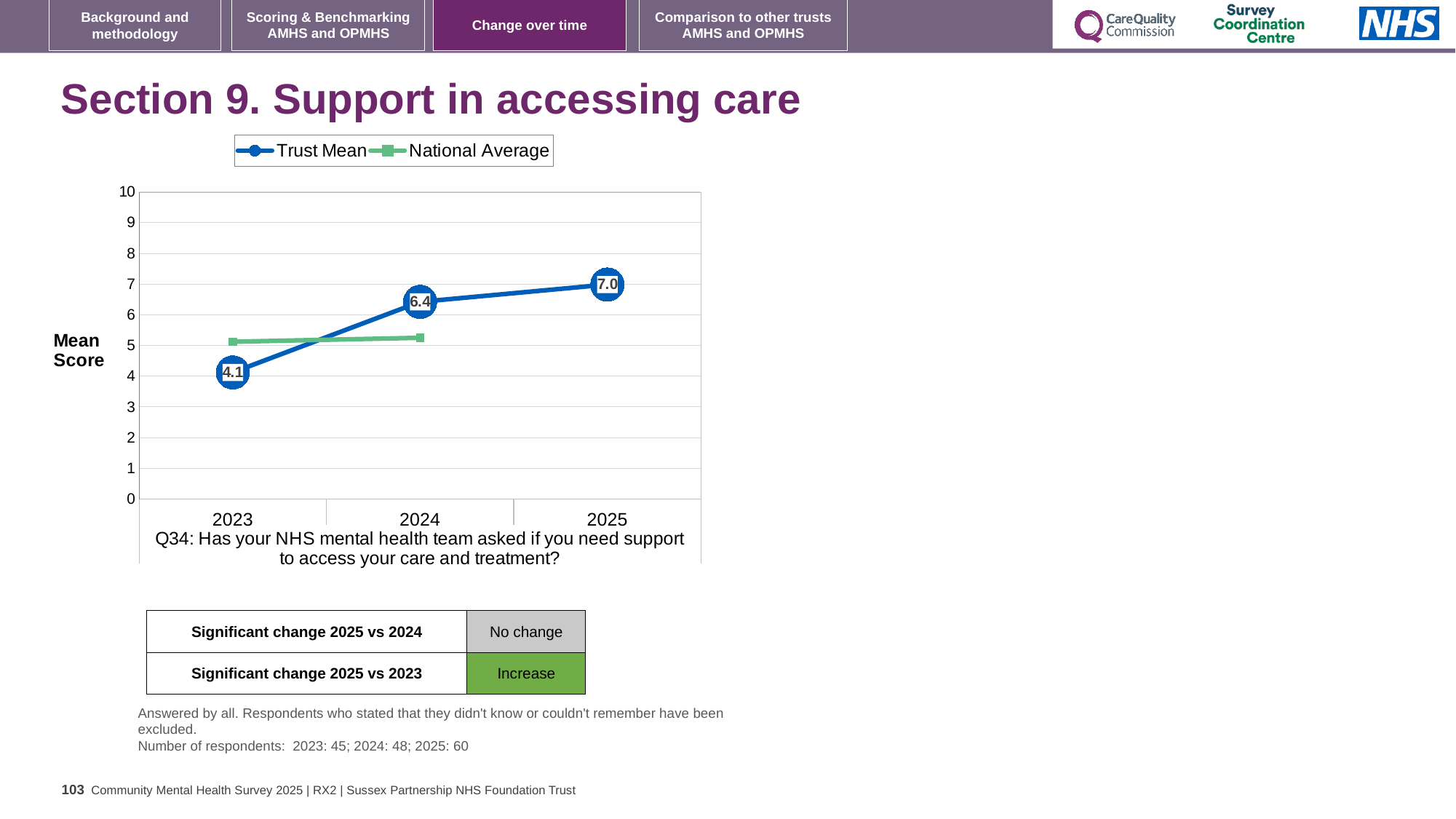
What kind of chart is shown on the slide? Line chart Is the National Average value for 2024 greater or less than 6? less How many series does the legend list? 2 Does the Trust Mean rise or fall from 2023 to 2025? Rise What is the Trust Mean score for 2023? 4.1 In which year is the Trust Mean score lowest? 2023 What is the Trust Mean score for 2024? 6.4 What is the difference between the Trust Mean scores for 2024 and 2023? 2.3 What is the Trust Mean score for 2025? 7.0 What is the difference between the Trust Mean scores for 2025 and 2023? 2.9 Which is larger, the Trust Mean for 2023 or the National Average for 2023? National Average for 2023 In which year is the Trust Mean score highest? 2025